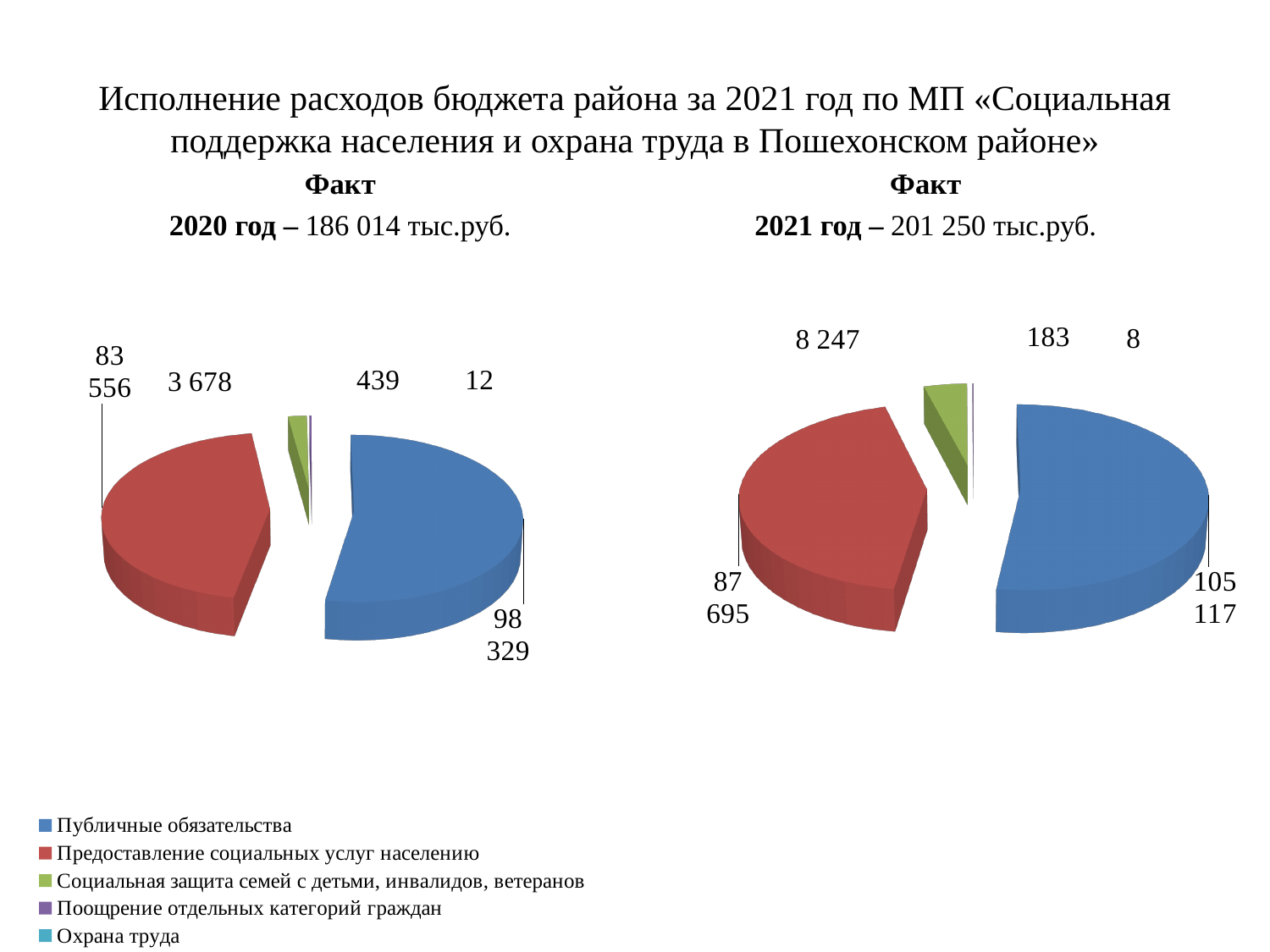
What colour represents Предоставление социальных услуг населению in the pie charts? Red In the 2021 pie chart, what is the value for Предоставление социальных услуг населению? 87 695 In the 2020 pie chart, what is the difference between Публичные обязательства and Предоставление социальных услуг населению? 14 773 In the 2020 pie chart, what is the value for Охрана труда? 12 In the 2020 pie chart, which category has the smallest value? Охрана труда In the 2021 pie chart, which category has the largest value? Публичные обязательства In the 2020 pie chart, what is the value for Публичные обязательства? 98 329 Which is larger in the 2021 pie chart: Поощрение отдельных категорий граждан or Социальная защита семей с детьми, инвалидов, ветеранов? Социальная защита семей с детьми, инвалидов, ветеранов What type of chart is used on this slide? Pie chart In the 2021 pie chart, what is the value for Социальная защита семей с детьми, инвалидов, ветеранов? 8 247 How many categories does the legend list for the pie charts? 5 What is the difference between the Публичные обязательства value in the 2021 chart and in the 2020 chart? 6 788